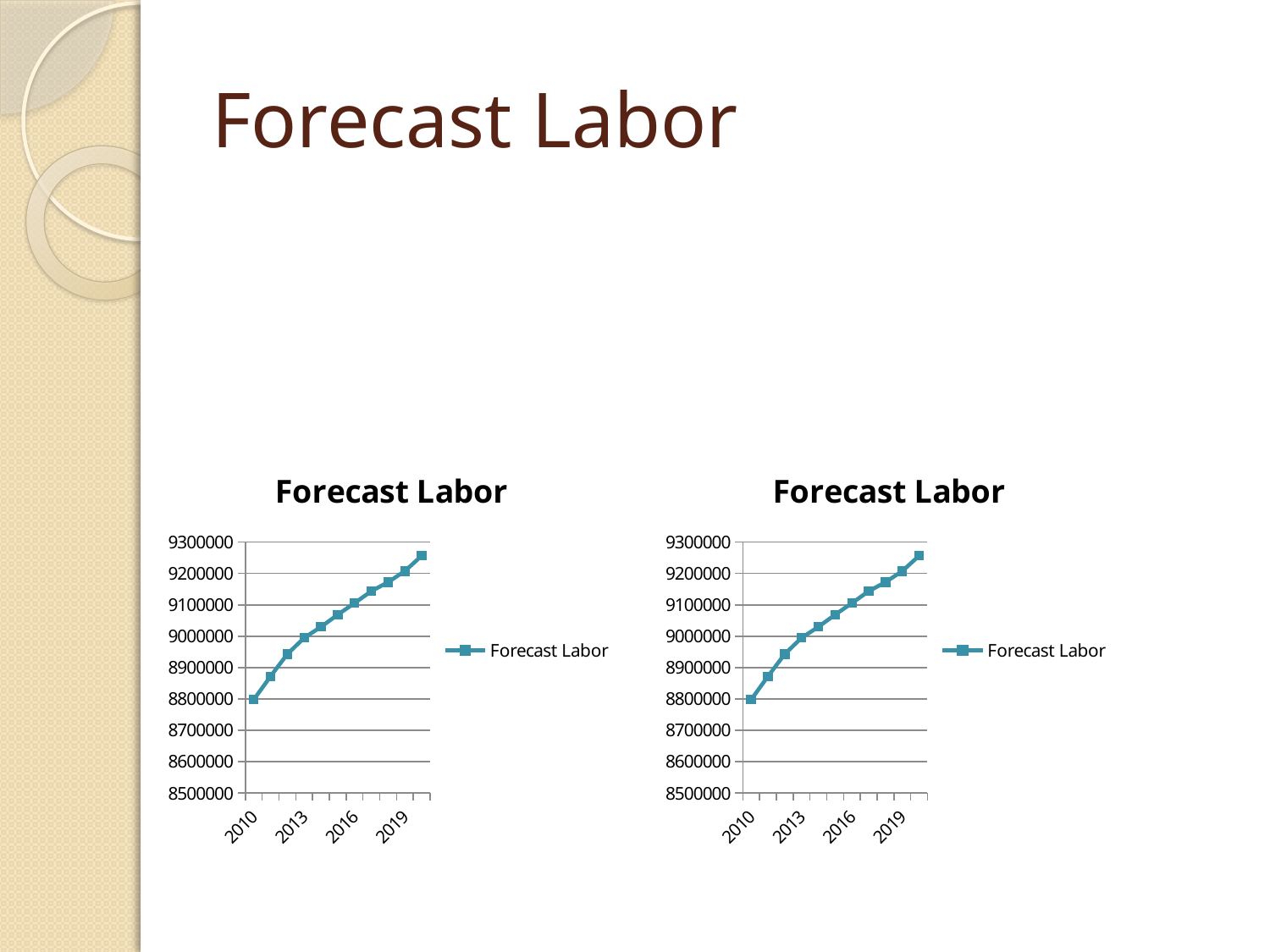
What is the title of the left chart? Forecast Labor In the right chart, is the value for 2019 greater or less than 9100000? greater In the left chart, which is larger, the value for 2013 or the value for 2019? 2019 How many series does the legend of the right chart list? 1 In the left chart, is the value for 2010 greater or less than 8900000? less In the right chart, which year has the lowest value? 2010 In the left chart, is the value for 2016 greater or less than 9000000? greater What kind of chart is the left 'Forecast Labor' chart? line chart What is the name of the series shown in the legend of the left chart? Forecast Labor In the right chart, what is the highest value shown on the vertical axis? 9300000 In the left chart, do the values rise or fall from 2010 to 2019? rise